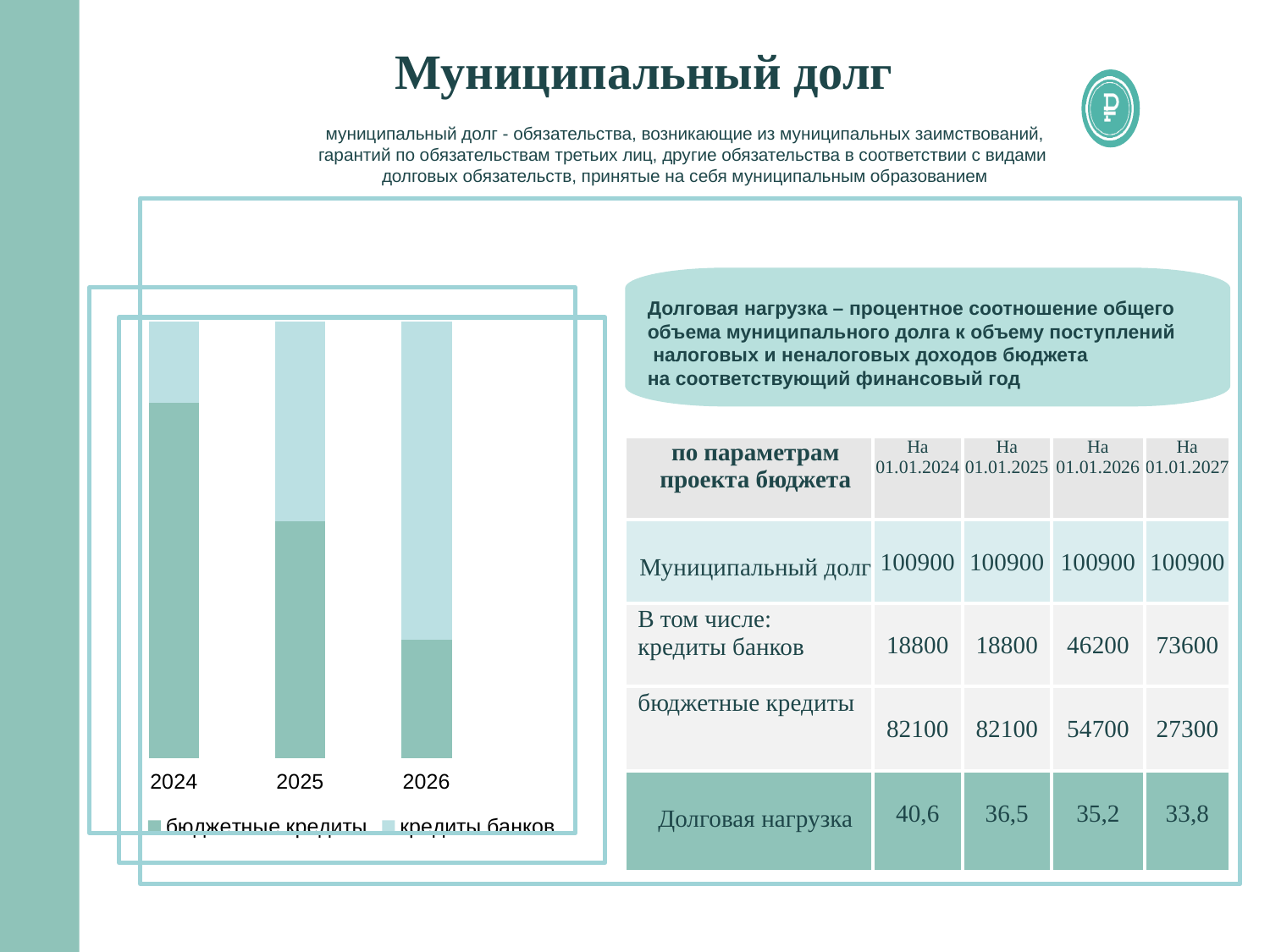
Which series is shown in the darker green colour in the bar chart? бюджетные кредиты How many years are shown on the x axis of the bar chart? 3 In which year is the бюджетные кредиты segment the smallest in the bar chart? 2026 What kind of chart is shown on the left of the slide? bar chart What are the two series named in the legend of the bar chart? бюджетные кредиты, кредиты банков In which year is the бюджетные кредиты segment the largest in the bar chart? 2024 In the 2026 bar, which segment is larger: бюджетные кредиты or кредиты банков? кредиты банков In which year is the кредиты банков segment the largest in the bar chart? 2026 In the 2024 bar, which segment is larger: бюджетные кредиты or кредиты банков? бюджетные кредиты Does the бюджетные кредиты segment rise or fall from 2024 to 2026 in the bar chart? fall Does the кредиты банков segment rise or fall from 2024 to 2026 in the bar chart? rise How many series does the legend of the bar chart list? 2